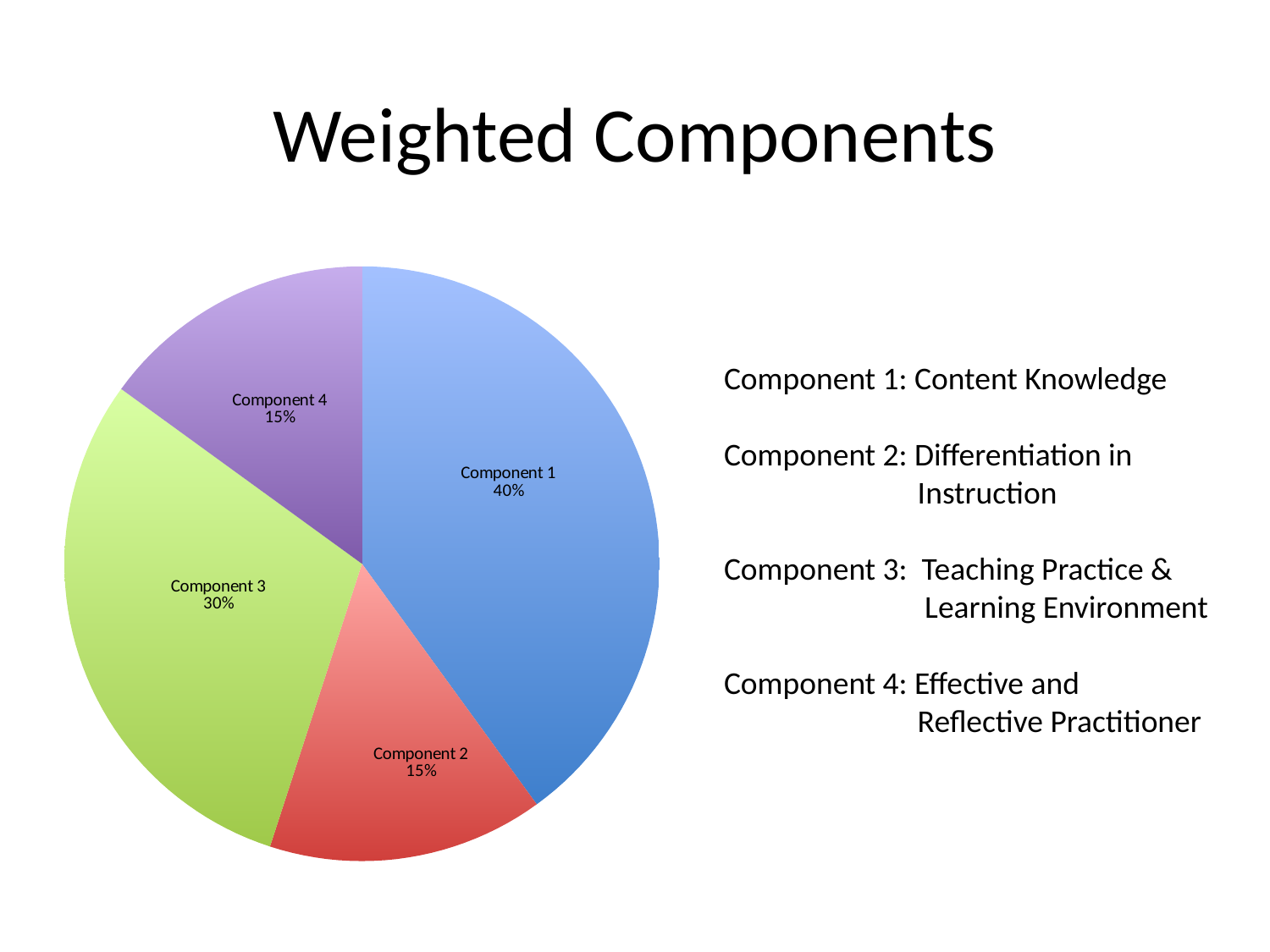
What is the difference between the shares of Component 3 and Component 2? 15% What is the title of the slide containing the chart? Weighted Components How many slices does the pie chart have? 4 Which component has the largest slice of the pie? Component 1 What kind of chart is shown on the slide? Pie chart What is the difference between the shares of Component 1 and Component 3? 10% What share of the pie does Component 3 represent? 30% What share of the pie does Component 1 represent? 40% Which is larger, the share for Component 3 or the share for Component 4? Component 3 What colour is the slice for Component 3? Green What is the value shown for Component 2? 15% What is the value shown for Component 4? 15%